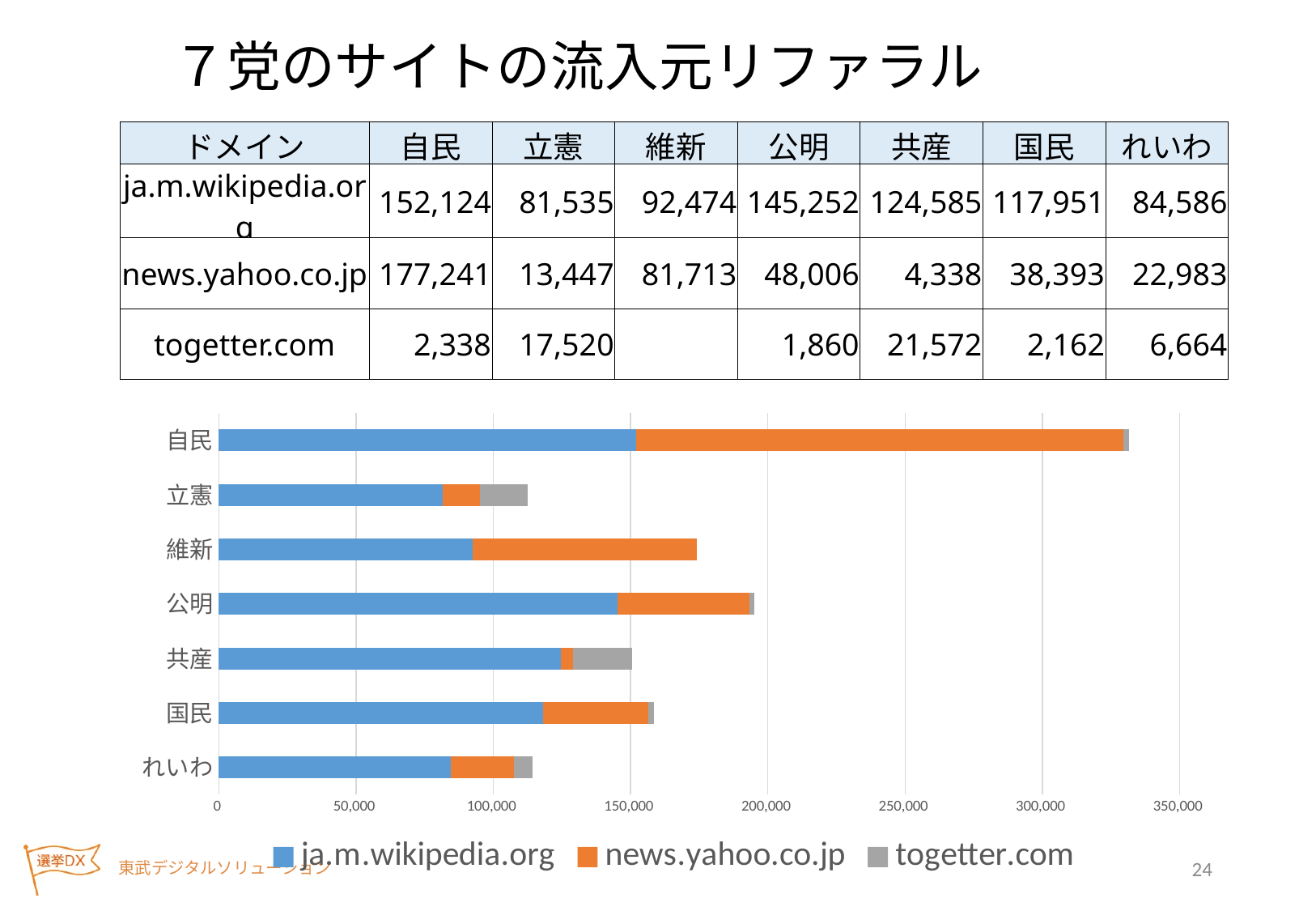
What is the total of the stacked bar for 自民? 331,703 What is the togetter.com value for れいわ? 6,664 What is the news.yahoo.co.jp value for 維新? 81,713 Is the total stacked bar for 公明 greater or less than 150,000? greater How many parties (categories) are plotted in the bar chart? 7 What is the difference between the news.yahoo.co.jp values for 自民 and 公明? 129,235 Which is larger, the togetter.com value for 共産 or for 立憲? 共産 Which party has the longest total stacked bar? 自民 Which party has the highest ja.m.wikipedia.org value? 自民 What is the ja.m.wikipedia.org value for 自民? 152,124 What kind of chart is shown on the slide? stacked bar chart How many series does the chart legend list? 3